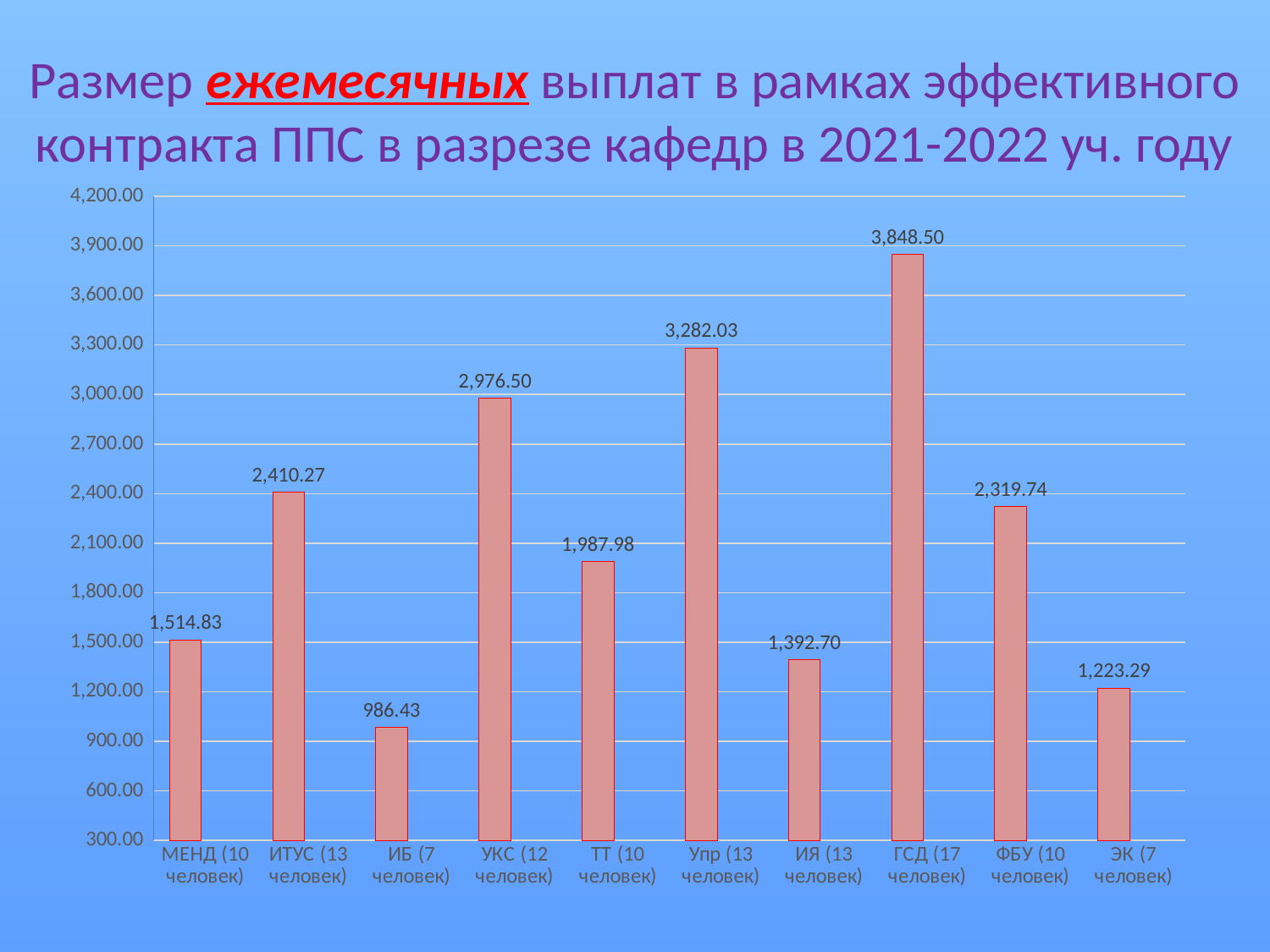
What is the value for ИБ (7 человек)? 986.43 Which department has the lowest value? ИБ (7 человек) How many departments are shown on the chart? 10 Which is larger, the value for ФБУ (10 человек) or the value for ИТУС (13 человек)? ИТУС (13 человек) What is the value for Упр (13 человек)? 3,282.03 Is the value for ТТ (10 человек) greater or less than 2,100.00? less What kind of chart is shown on the slide? bar chart What is the value for ГСД (17 человек)? 3,848.50 Which department has the highest value? ГСД (17 человек) What is the difference between the values for ГСД (17 человек) and ИБ (7 человек)? 2,862.07 What is the value for ЭК (7 человек)? 1,223.29 What is the difference between the values for УКС (12 человек) and ИТУС (13 человек)? 566.23